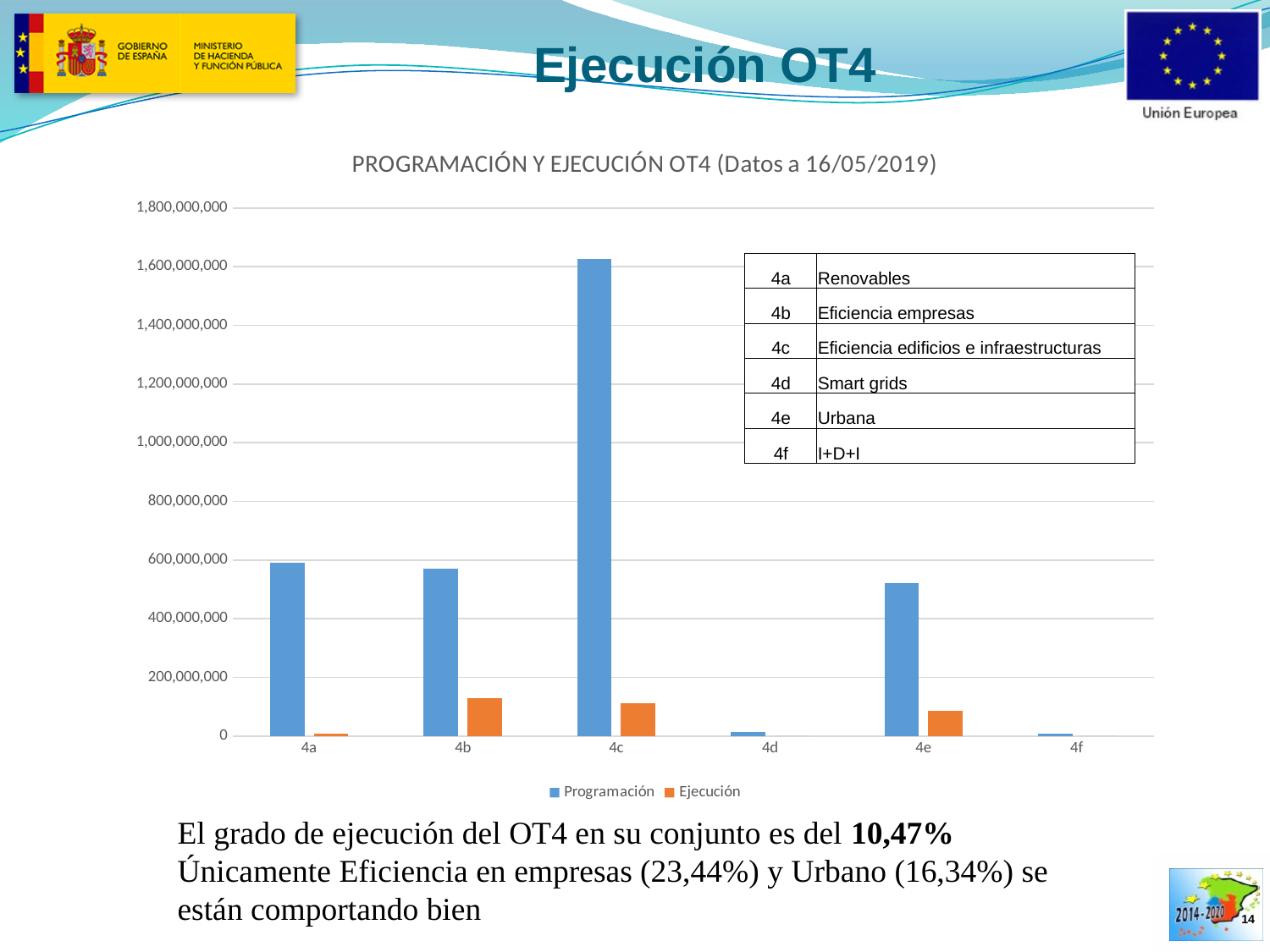
Is the Ejecución value for 4b greater or less than 200,000,000? less Is the Programación value for 4c greater or less than 1,400,000,000? greater Is the Programación value for 4a greater or less than 400,000,000? greater Which is larger, the Programación value for 4a or the Programación value for 4e? 4a What kind of chart is shown on the slide? bar chart What is the title of the chart? PROGRAMACIÓN Y EJECUCIÓN OT4 (Datos a 16/05/2019) Which category has the highest Programación value? 4c How many categories are shown on the x axis of the chart? 6 Which is larger, the Ejecución value for 4b or the Ejecución value for 4e? 4b How many series does the chart legend list? 2